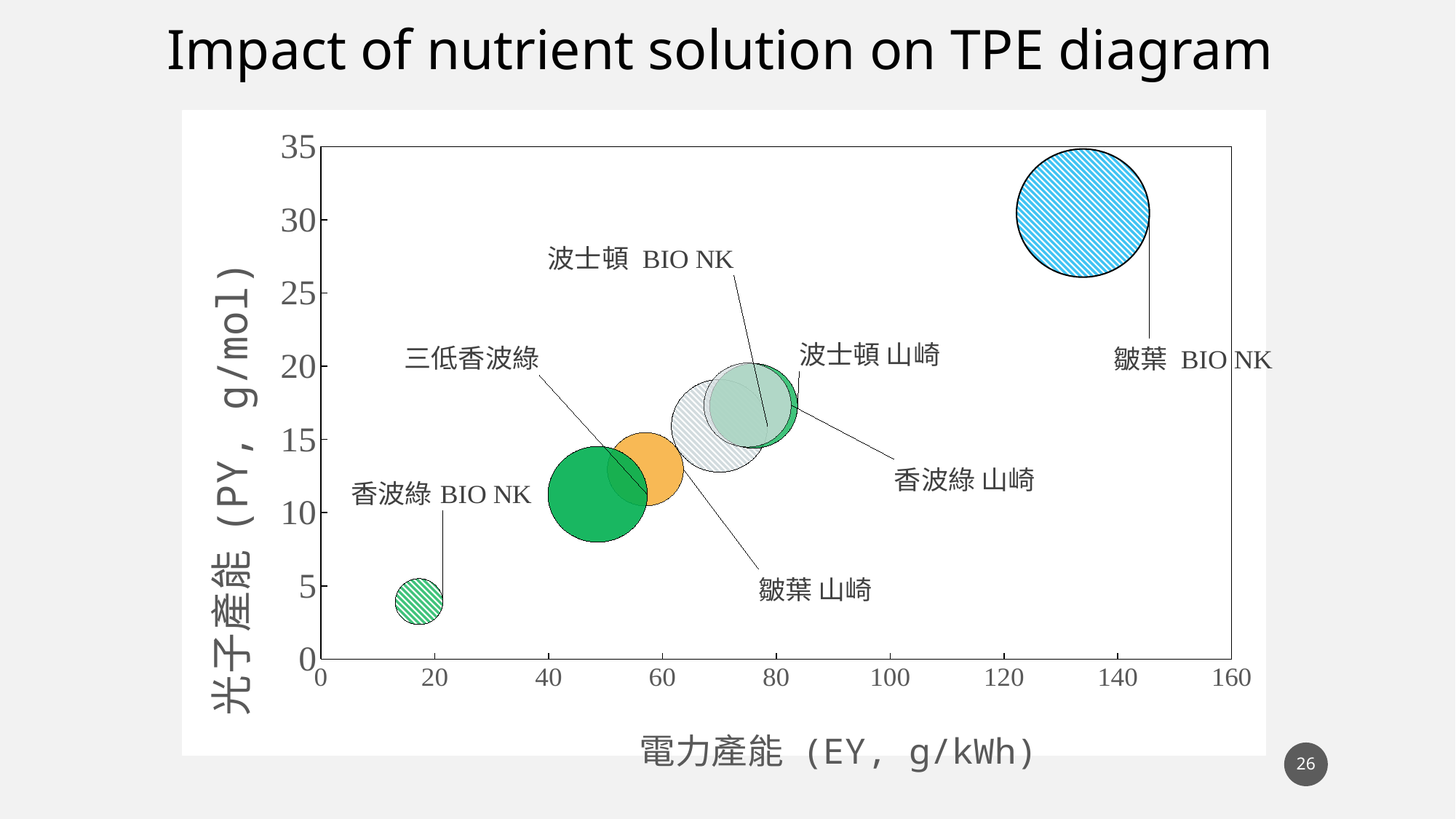
What is the title of the slide's chart? Impact of nutrient solution on TPE diagram How many labelled bubbles are plotted on the chart? 7 Is the electricity yield (EY) for 皺葉 BIO NK greater or less than 120? greater Which labelled bubble has the highest electricity yield (EY)? 皺葉 BIO NK Which labelled bubble has the highest photon yield (PY)? 皺葉 BIO NK What is the label of the x axis? 電力產能 (EY, g/kWh) Which has a higher photon yield (PY), 皺葉 BIO NK or 香波綠 BIO NK? 皺葉 BIO NK What kind of chart is shown on the slide? bubble chart Is the electricity yield (EY) for 香波綠 BIO NK greater or less than 20? less Is the photon yield (PY) for 皺葉 BIO NK greater or less than 25? greater Which labelled bubble has the lowest photon yield (PY)? 香波綠 BIO NK Do the bubbles' photon yield (PY) values generally rise or fall as electricity yield (EY) increases? rise